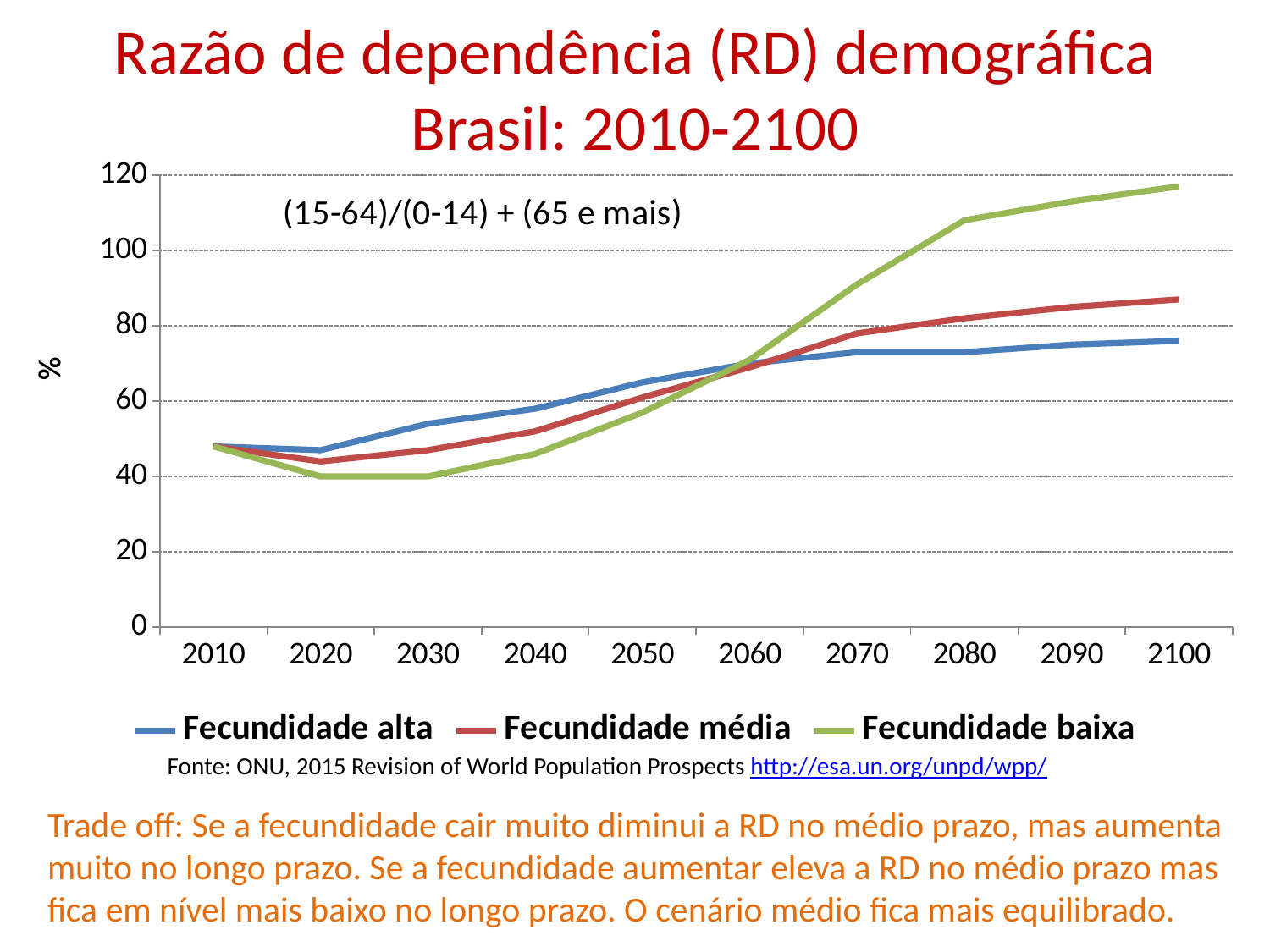
In 2030, which is larger: Fecundidade alta or Fecundidade baixa? Fecundidade alta In 2100, which is larger: Fecundidade média or Fecundidade alta? Fecundidade média Is the value for Fecundidade média in 2040 greater or less than 60? less Which series has the highest value in 2100? Fecundidade baixa Is the value for Fecundidade alta in 2100 greater or less than 80? less Does the Fecundidade baixa line rise or fall from 2030 to 2100? rise Is the value for Fecundidade baixa in 2100 greater or less than 100? greater What kind of chart is shown on the slide? line chart How many years are marked along the x axis? 10 How many series does the legend list? 3 What is the label on the y axis? % Which series has the lowest value in 2030? Fecundidade baixa